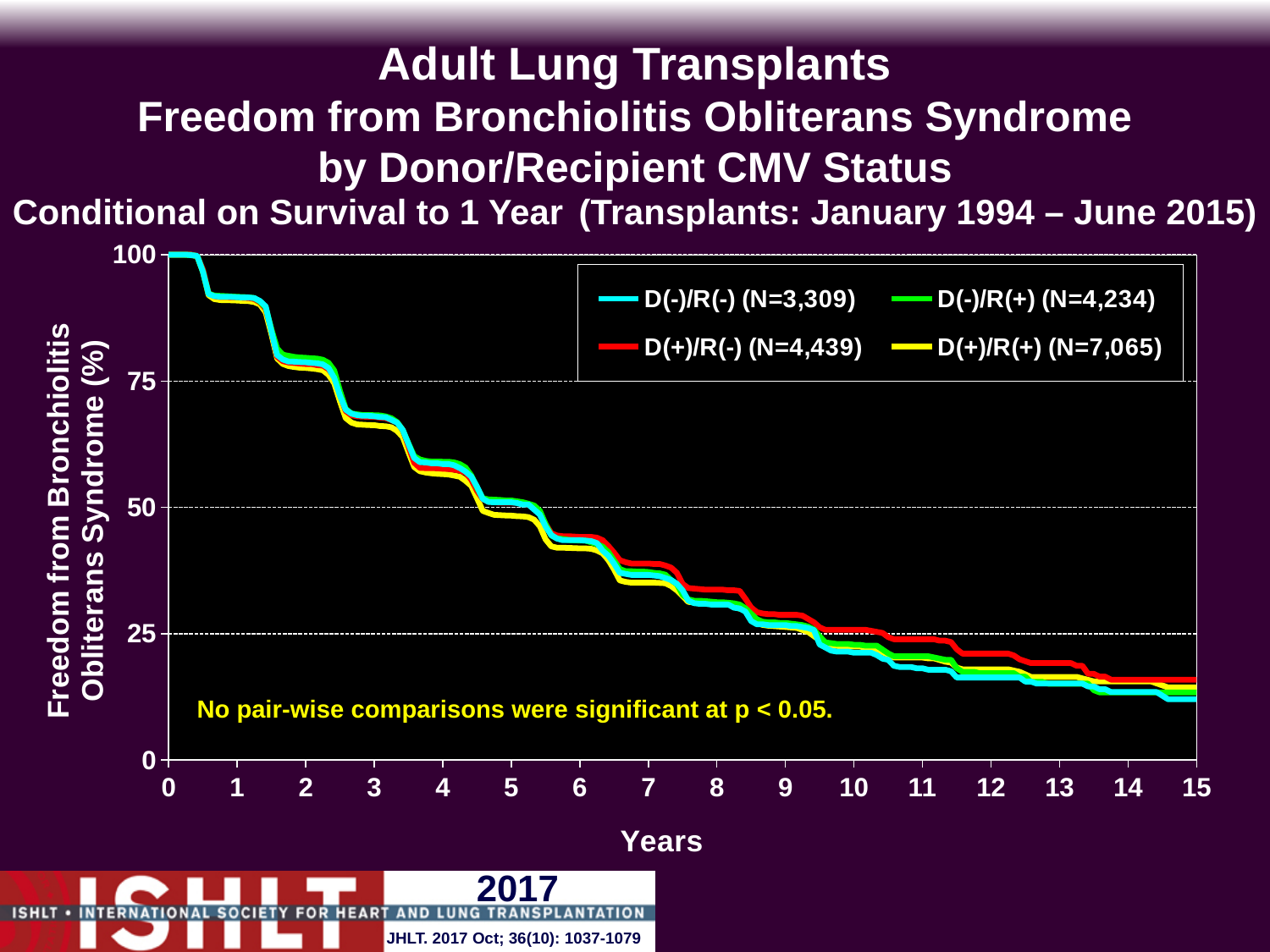
What kind of chart is shown on the slide? Line chart Which colour represents the D(+)/R(-) (N=4,439) series? Red Is the value for D(+)/R(+) at year 1 greater or less than 75? greater Is the value for D(-)/R(-) at year 3 greater or less than 50? greater How many series does the legend list? 4 What is the maximum value shown on the x axis (Years)? 15 Is the value for D(+)/R(-) at year 6 greater or less than 50? less Do the freedom from bronchiolitis obliterans syndrome curves rise or fall as years increase? Fall According to the legend, what is the N for the D(+)/R(+) group? N=7,065